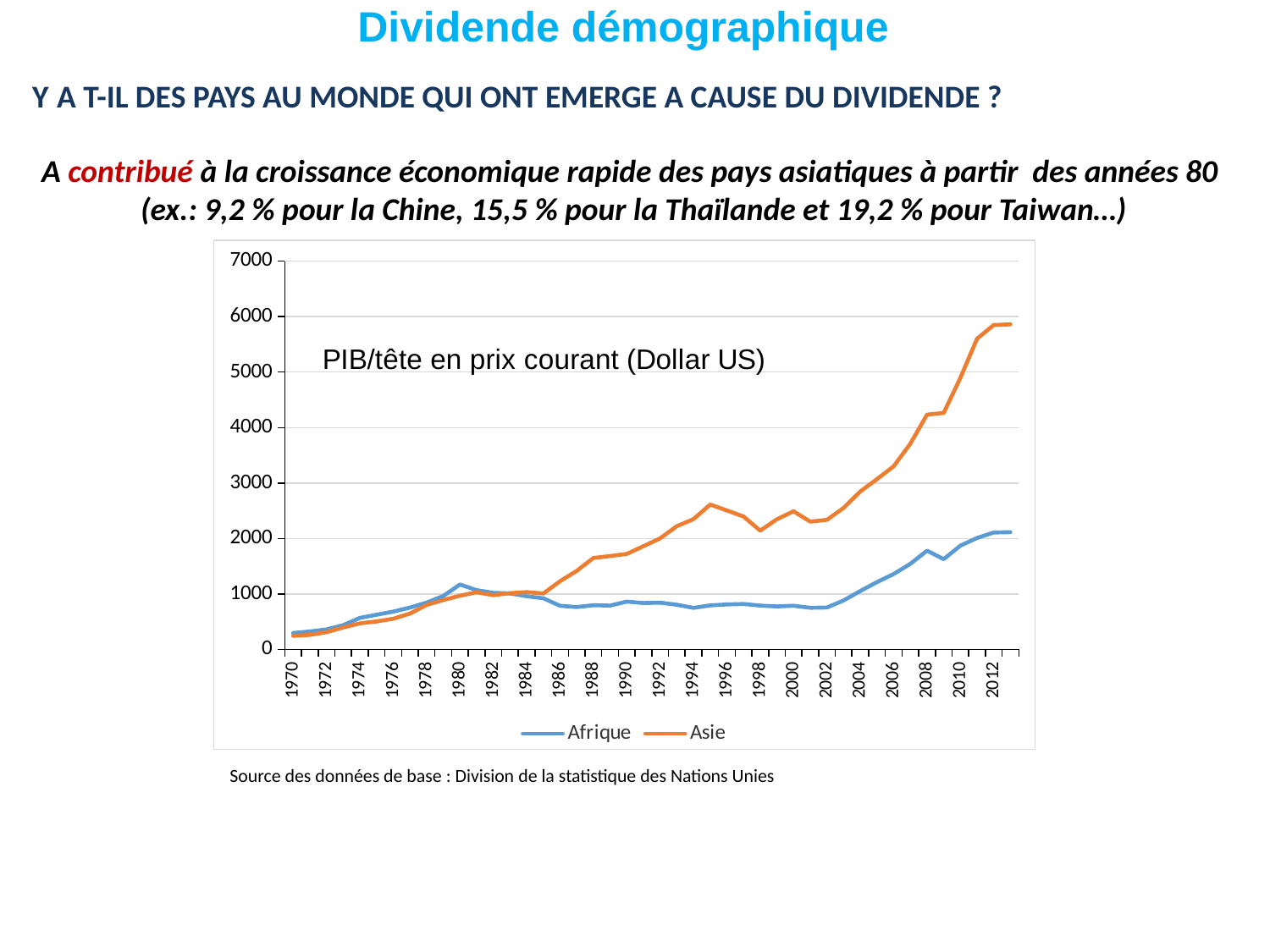
What are the two series named in the legend? Afrique and Asie How many series does the legend list? 2 Does the Asie line rise or fall between 2002 and 2012? rise Is the value for Afrique in 1970 greater or less than 1000? less Does the Afrique line rise or fall between 1980 and 1986? fall Which series reaches the highest value on the chart? Asie Which series has the higher value in 2010, Afrique or Asie? Asie Is the value for Afrique in 2000 greater or less than 1000? less What text label is printed inside the plot area of the chart? PIB/tête en prix courant (Dollar US) Is the value for Asie in 2012 greater or less than 5000? greater What kind of chart is shown on the slide? line chart